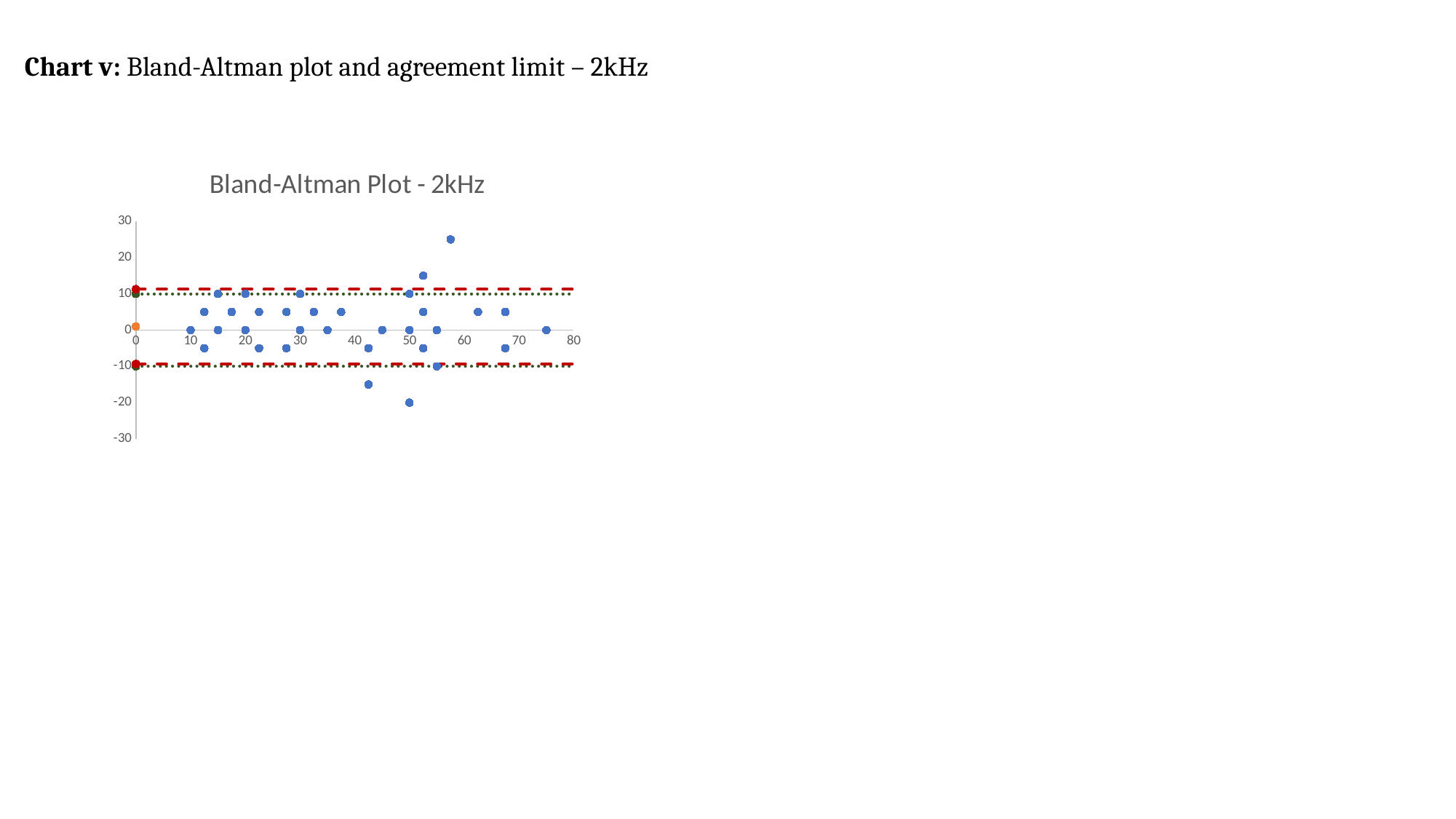
Is the highest blue point located at an x value greater or less than 50? greater Is the upper dashed red agreement limit line greater or less than 0? greater Is the value of the lowest blue point on the chart greater or less than -10? less What kind of chart is shown on the slide? Scatter chart What is the title of the chart? Bland-Altman Plot - 2kHz What is the maximum value shown on the x axis? 80